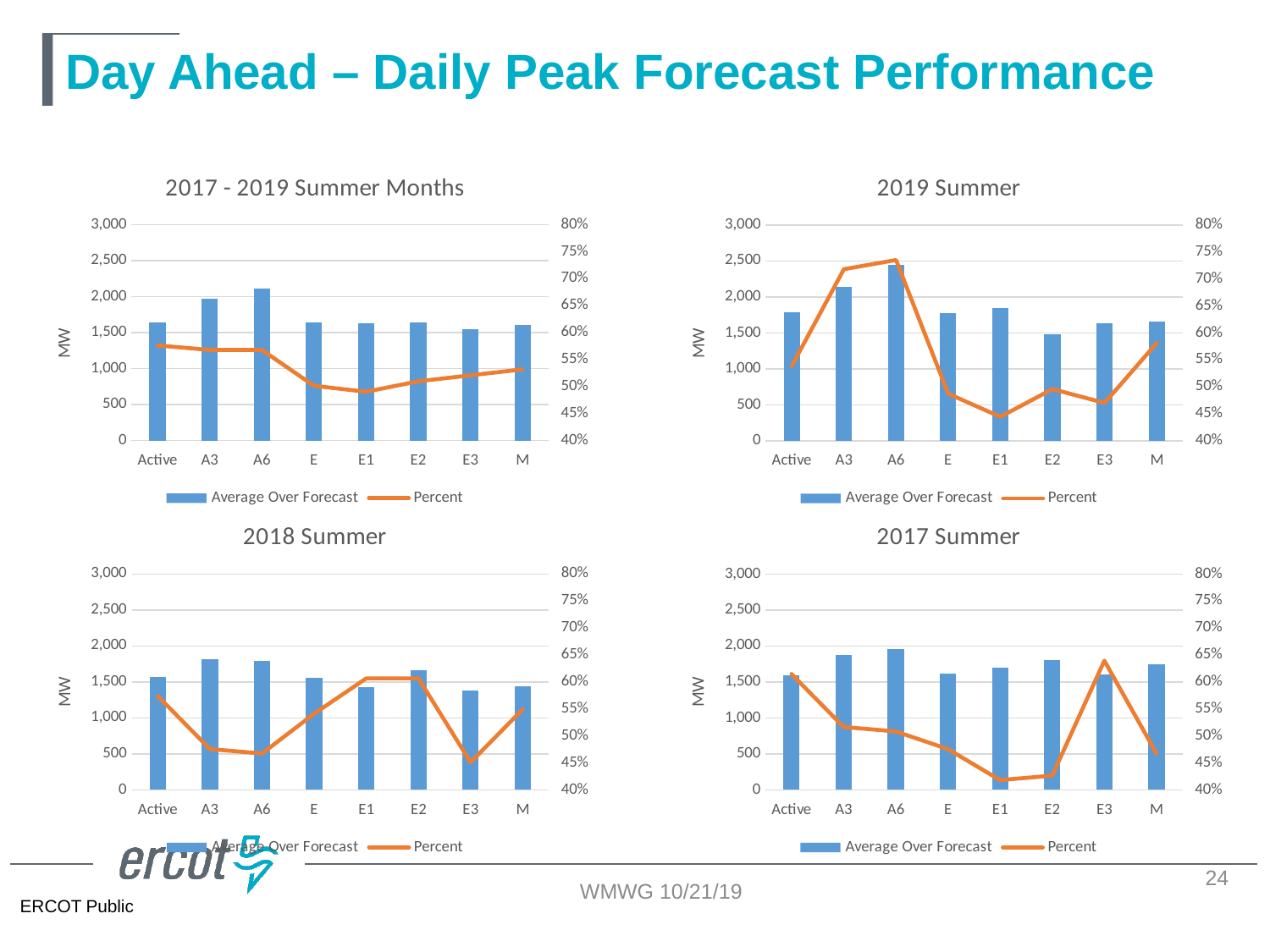
What are the two legend entries in the '2017 Summer' chart? Average Over Forecast and Percent In the '2019 Summer' chart, which category has the highest Percent value? A6 In the '2019 Summer' chart, which has the larger Average Over Forecast bar, A3 or E2? A3 In the '2018 Summer' chart, which category has the lowest Percent value? E3 In the '2019 Summer' chart, which category has the lowest Average Over Forecast bar? E2 In the '2017 - 2019 Summer Months' chart, which category has the highest Average Over Forecast bar? A6 In the '2019 Summer' chart, is the Average Over Forecast value for A6 greater or less than 2,000? greater In the '2017 - 2019 Summer Months' chart, how many categories are shown on the x axis? 8 What kind of chart is the '2018 Summer' chart? Bar chart with a line In the '2019 Summer' chart, how many series does the legend list? 2 How many charts are on the slide? 4 In the '2017 Summer' chart, which category has the highest Average Over Forecast bar? A6